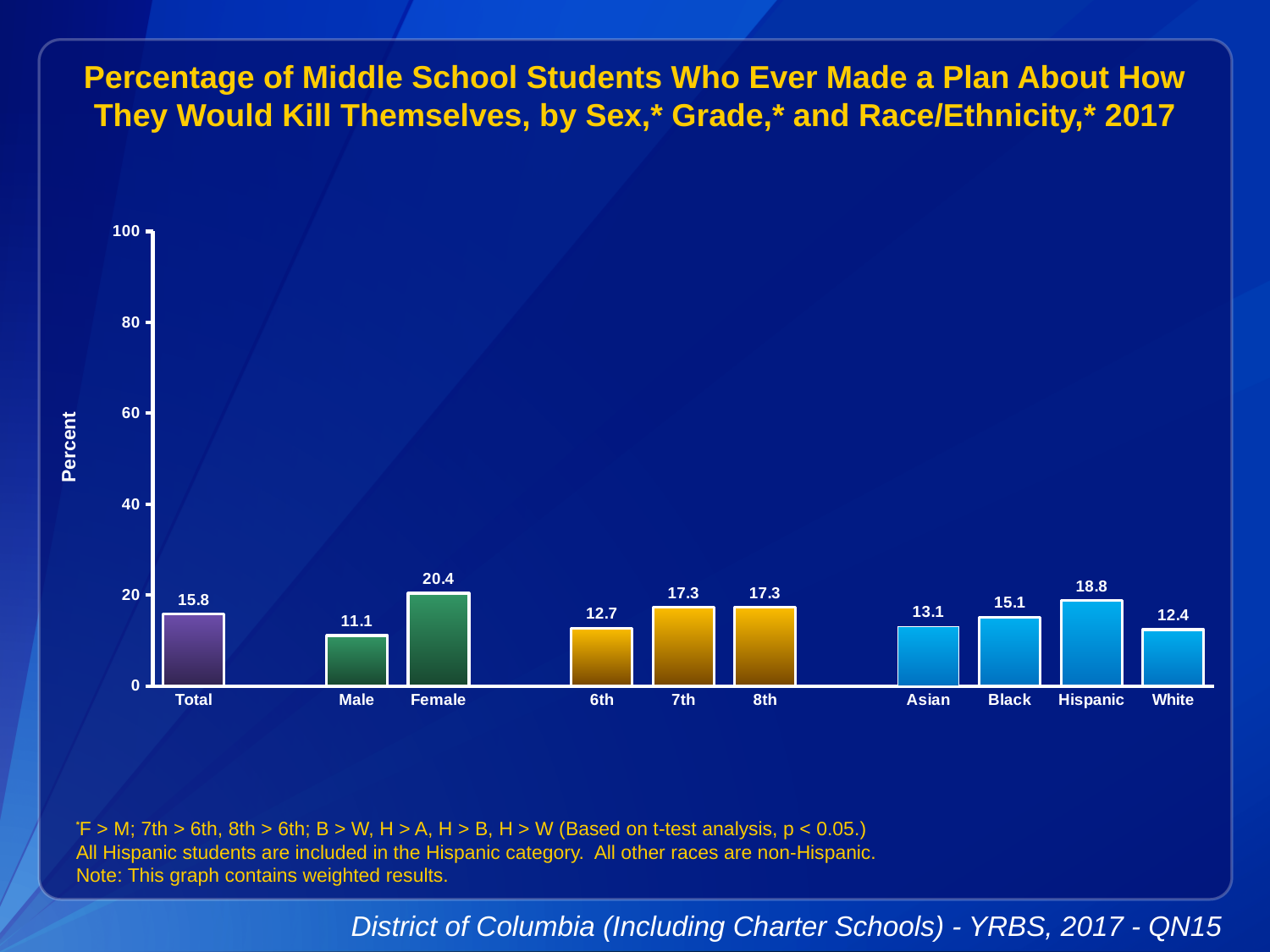
What is the value for Female? 20.4 Is the value for 6th greater or less than 20? less What is the difference between the values for Female and Male? 9.3 What is the difference between the values for Hispanic and Asian? 5.7 What is the value for Total? 15.8 Which category has the highest value? Female Which category has the lowest value? Male What is the value for Hispanic? 18.8 Which is larger, the value for Black or the value for White? Black What is the label on the y axis? Percent What kind of chart is this? bar chart How many categories are shown on the x axis? 10